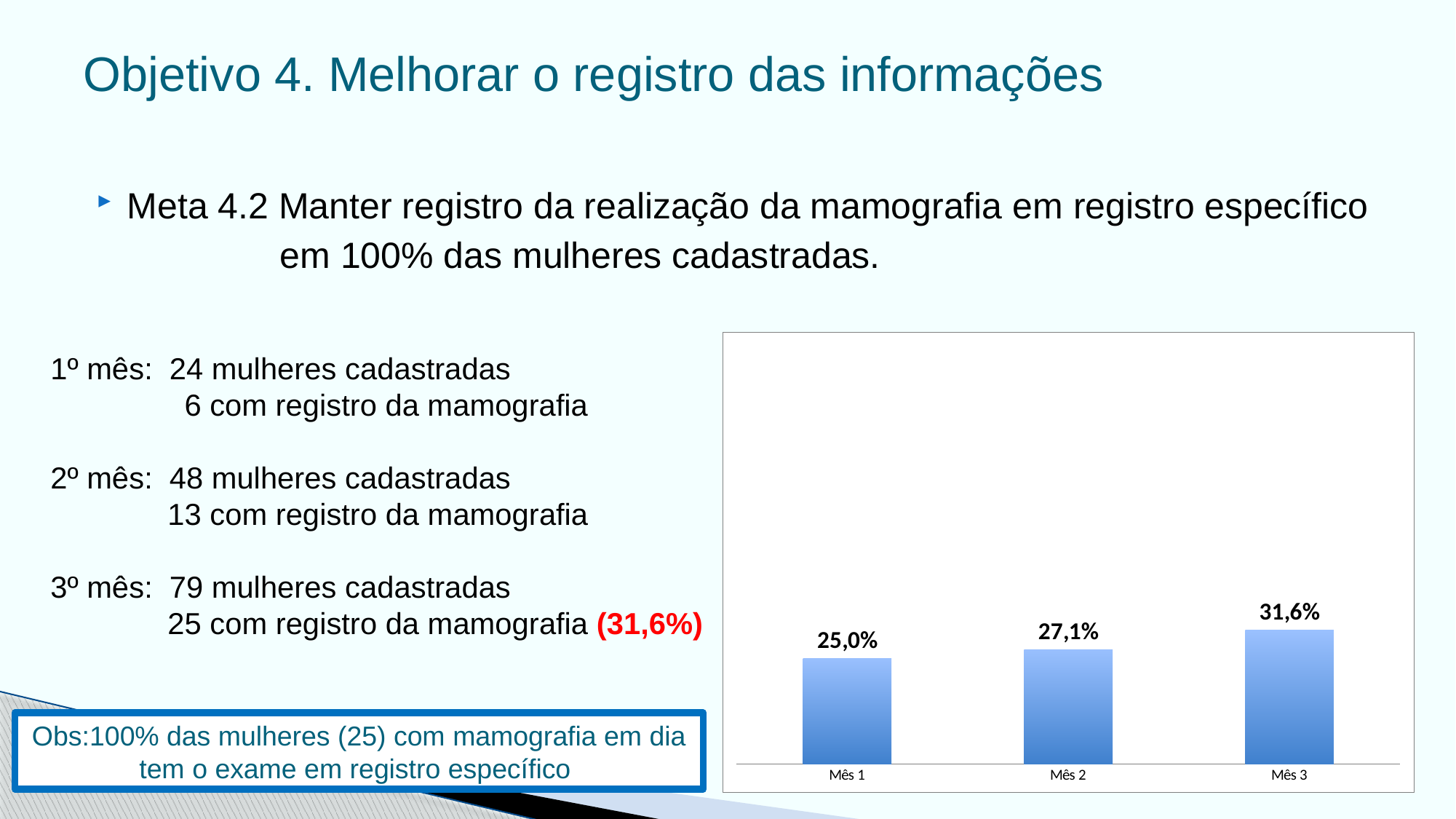
What is the value shown for Mês 2 in the chart? 27,1% Which is larger, the value for Mês 2 or the value for Mês 3? Mês 3 How many bars are plotted in the chart? 3 What is the difference between the values for Mês 2 and Mês 1? 2,1% Do the values rise or fall from Mês 1 to Mês 3? Rise What kind of chart is shown on the slide? Bar chart What is the value shown for Mês 3 in the chart? 31,6% What is the value shown for Mês 1 in the chart? 25,0% Which month has the highest value in the chart? Mês 3 Which month has the lowest value in the chart? Mês 1 What is the difference between the values for Mês 3 and Mês 1? 6,6% What is the difference between the values for Mês 3 and Mês 2? 4,5%